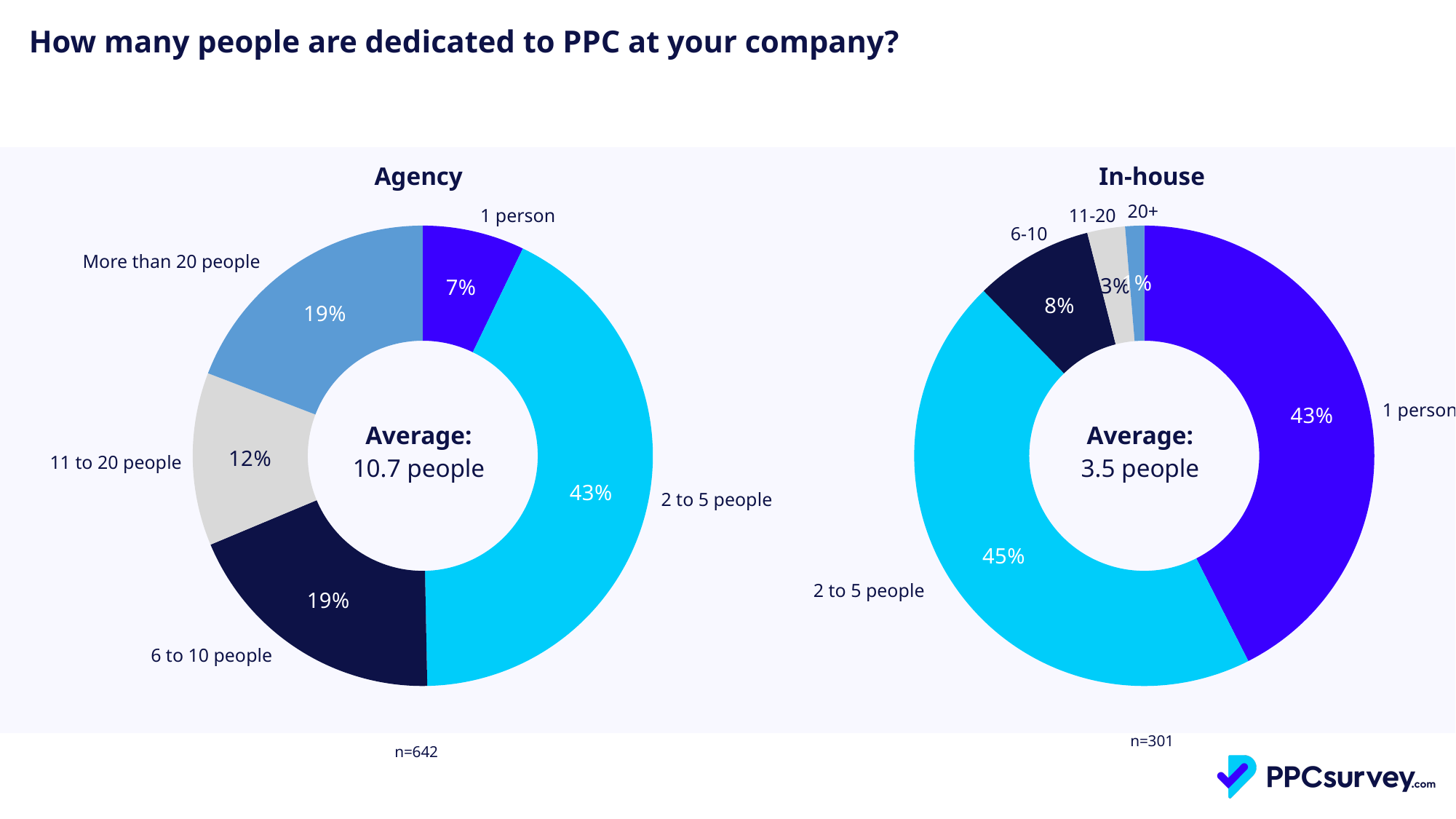
In the Agency chart, which category has the smallest share? 1 person In the Agency chart, what share is shown for 11 to 20 people? 12% Which is larger in the In-house chart: the share for 6-10 people or the share for 11-20 people? 6-10 In the In-house chart, which category has the largest share? 2 to 5 people In the Agency chart, what is the difference between the share for 2 to 5 people and the share for 1 person? 36 percentage points In the In-house chart, what percentage is shown for 6-10 people? 8% In the Agency chart, which category has the largest share? 2 to 5 people In the In-house chart, what percentage is shown for 1 person? 43% How many categories does the Agency chart show? 5 In the Agency chart, what percentage of respondents have 2 to 5 people dedicated to PPC? 43% What type of chart is used for the Agency data? Donut (pie) chart What average number of people is shown in the centre of the In-house chart? 3.5 people